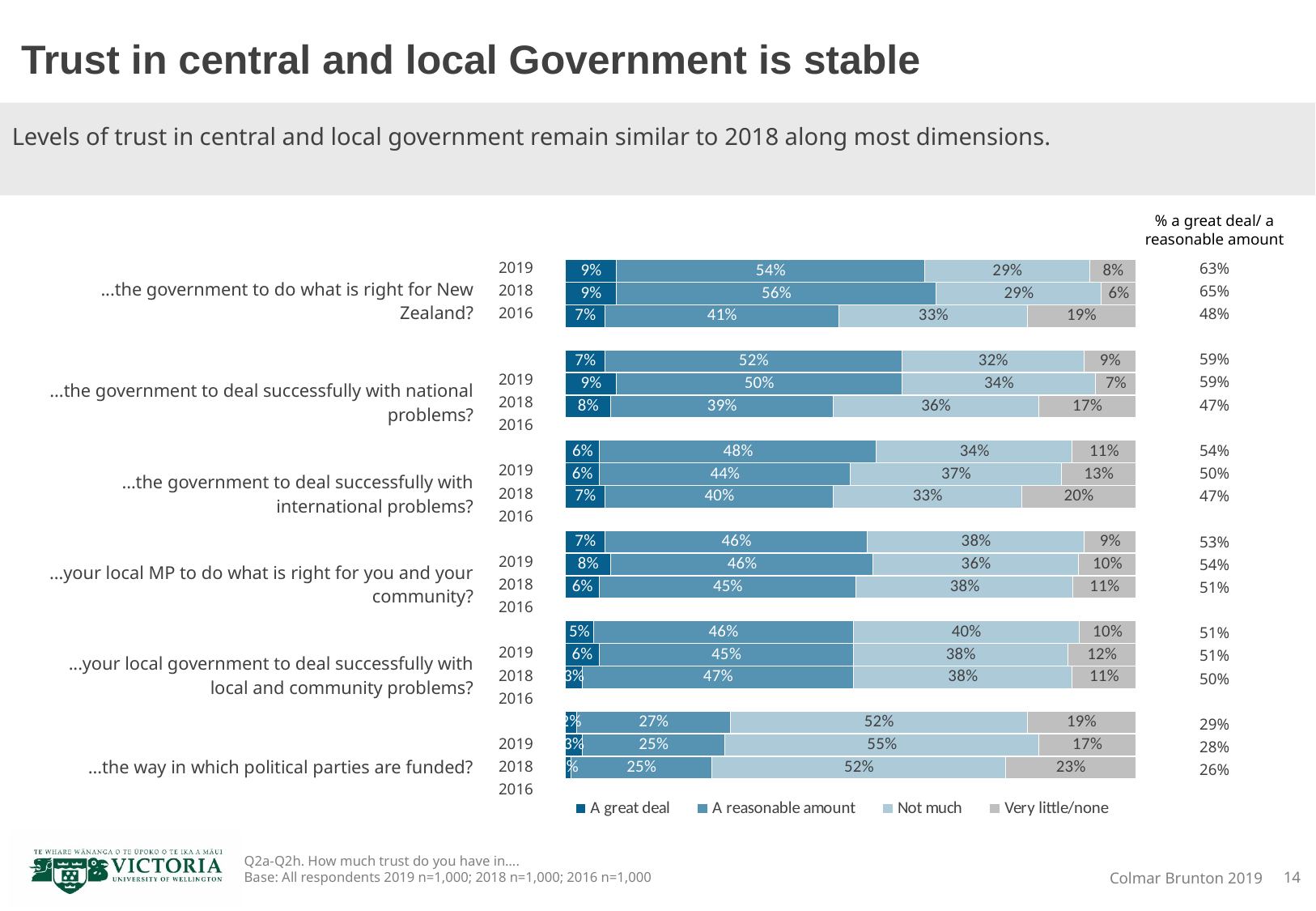
Which item has the highest '% a great deal/ a reasonable amount' figure in 2019? ...the government to do what is right for New Zealand? What is the 'Not much' value for 2018 for trusting the government to deal successfully with international problems? 37% How many series does the legend list? 4 What is the difference between the 2019 and 2016 '% a great deal/ a reasonable amount' figures for trusting the government to do what is right for New Zealand? 15 percentage points What is the combined '% a great deal/ a reasonable amount' figure for 2016 for the way in which political parties are funded? 26% What percentage of respondents in 2019 said they trust the government 'a reasonable amount' to do what is right for New Zealand? 54% How many trust items (question dimensions) are shown in the chart? 6 For trusting the government to deal successfully with national problems, is the 'Very little/none' value larger in 2019 or in 2016? 2016 Which years are compared for each item in the chart? 2019, 2018 and 2016 What is the 'Very little/none' value for 2016 for trusting the government to deal successfully with international problems? 20% Which item has the lowest '% a great deal/ a reasonable amount' figure in 2019? ...the way in which political parties are funded? What kind of chart is shown on the slide? Stacked bar chart